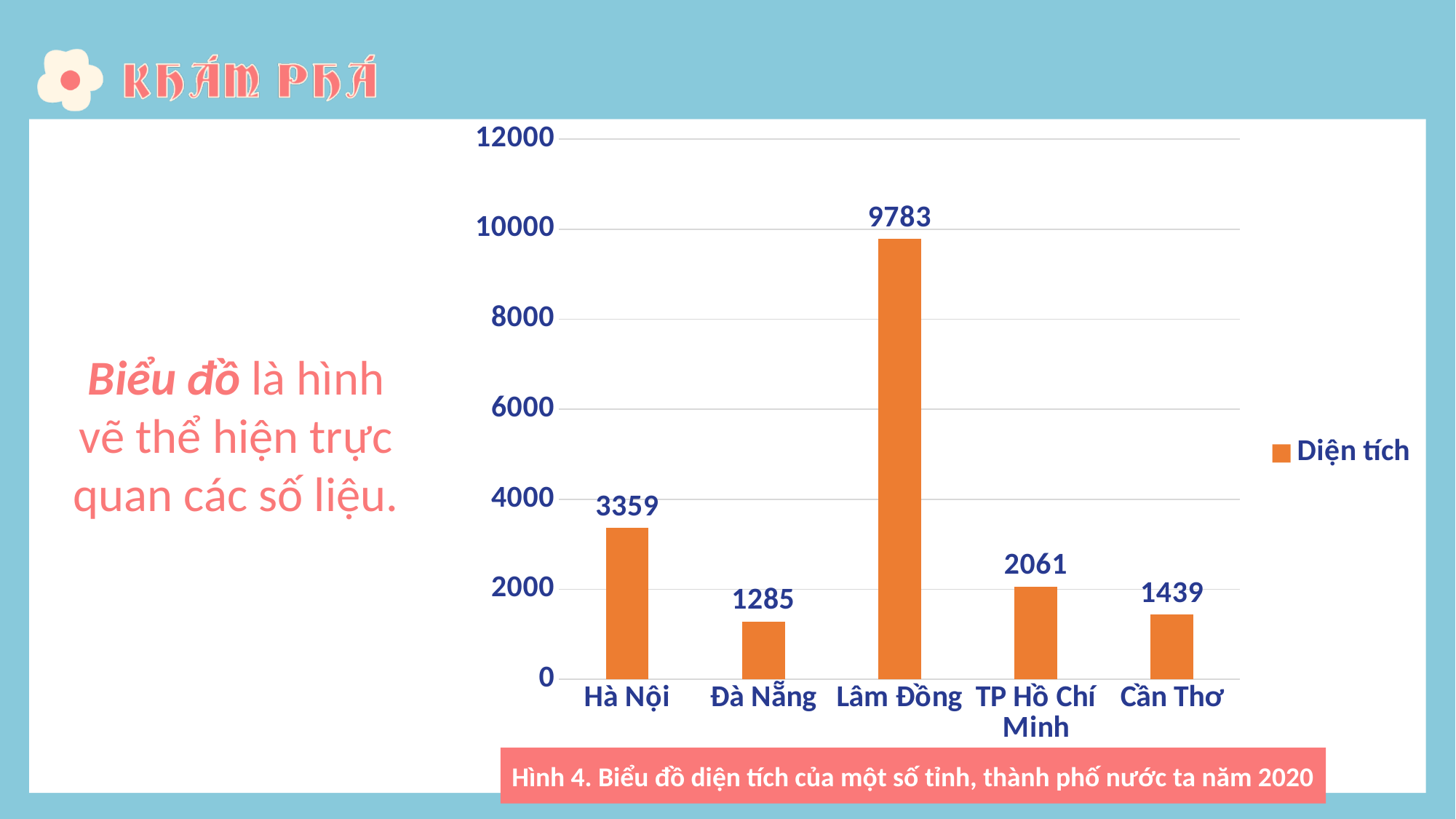
What kind of chart is shown? bar chart How many categories are shown on the x axis? 5 How many series does the legend list? 1 Which is larger, the value for Đà Nẵng or the value for Cần Thơ? Cần Thơ What is the value for Cần Thơ? 1439 What is the name of the series shown in the legend? Diện tích Which category has the lowest value? Đà Nẵng What is the value for Lâm Đồng? 9783 What is the value for Hà Nội? 3359 Which category has the highest value? Lâm Đồng What is the difference between the values for Hà Nội and TP Hồ Chí Minh? 1298 Is the value for TP Hồ Chí Minh greater or less than 4000? less